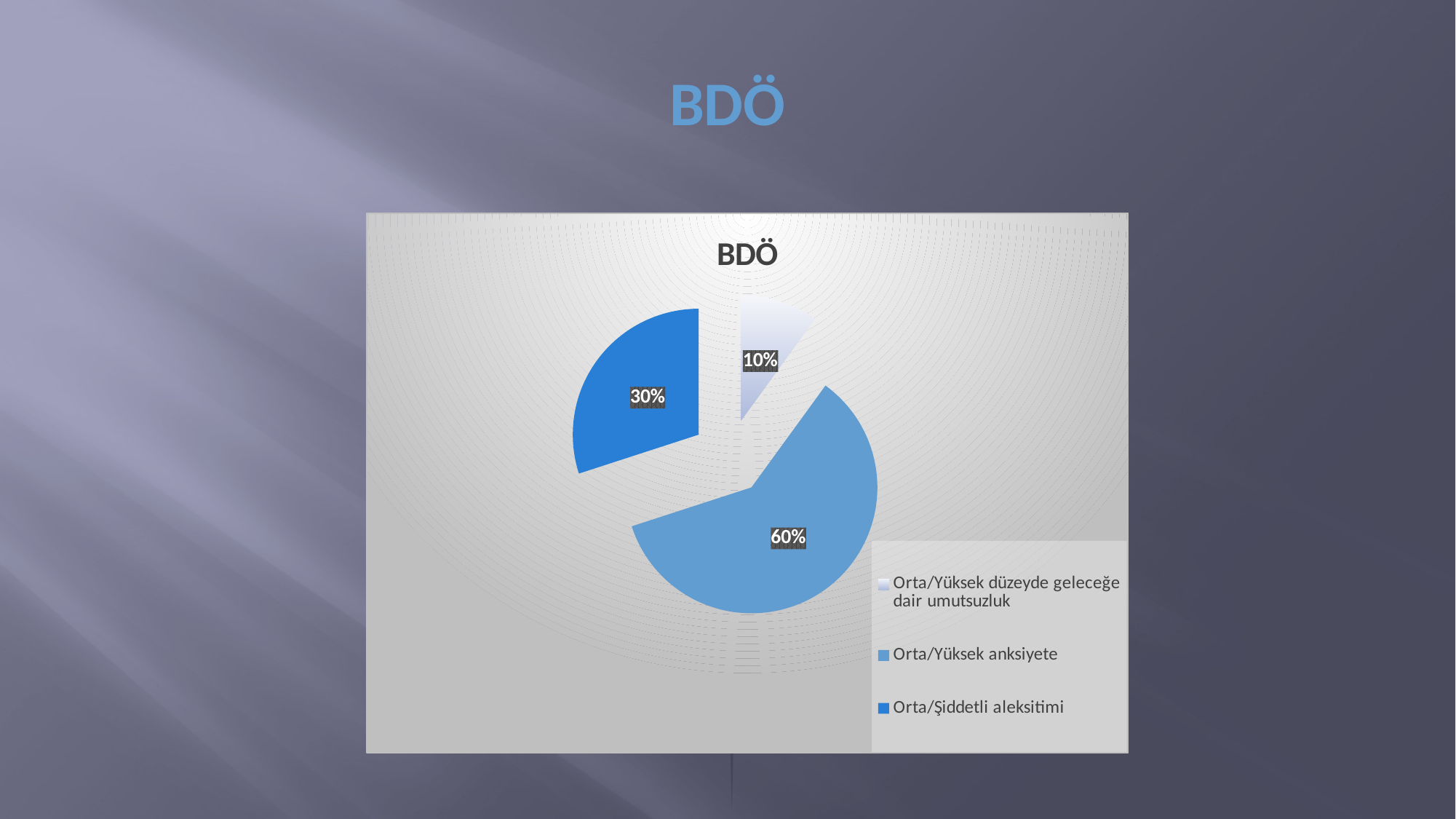
Which category has the largest slice of the pie? Orta/Yüksek anksiyete What kind of chart is shown on the slide? pie chart What share of the pie does "Orta/Yüksek anksiyete" take? 60% Which category has the smallest slice of the pie? Orta/Yüksek düzeyde geleceğe dair umutsuzluk What is the difference in percentage points between "Orta/Şiddetli aleksitimi" and "Orta/Yüksek düzeyde geleceğe dair umutsuzluk"? 20% What is the difference in percentage points between "Orta/Yüksek anksiyete" and "Orta/Şiddetli aleksitimi"? 30% What is the title of the chart? BDÖ How many slices does the pie chart have? 3 Which is larger: the slice for "Orta/Şiddetli aleksitimi" or the slice for "Orta/Yüksek düzeyde geleceğe dair umutsuzluk"? Orta/Şiddetli aleksitimi What share of the pie does "Orta/Şiddetli aleksitimi" take? 30% How many entries does the legend list? 3 What share of the pie does "Orta/Yüksek düzeyde geleceğe dair umutsuzluk" take? 10%